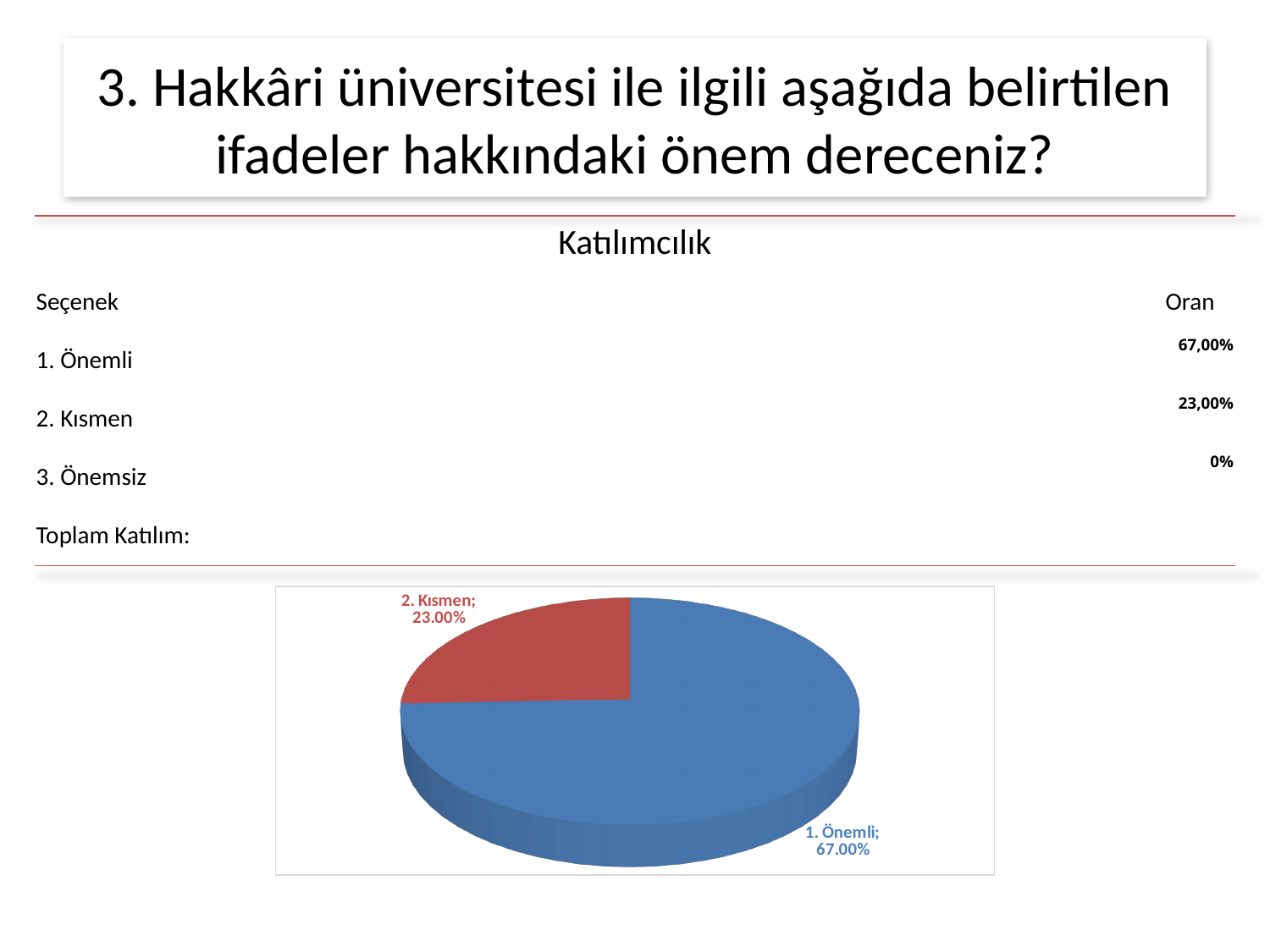
How many labelled slices does the pie chart show? 2 What is the value shown for the "2. Kısmen" slice in the pie chart? 23.00% Which is larger in the pie chart, "1. Önemli" or "2. Kısmen"? 1. Önemli What colour is the "2. Kısmen" slice in the pie chart? red What is the value shown for the "1. Önemli" slice in the pie chart? 67.00% What is the difference between the "1. Önemli" and "2. Kısmen" values in the pie chart? 44.00% What kind of chart is shown on the slide? pie chart What colour is the "1. Önemli" slice in the pie chart? blue According to the table above the chart, what is the Oran value for "3. Önemsiz"? 0% Which labelled slice of the pie chart is the smallest? 2. Kısmen Which slice of the pie chart is the largest? 1. Önemli